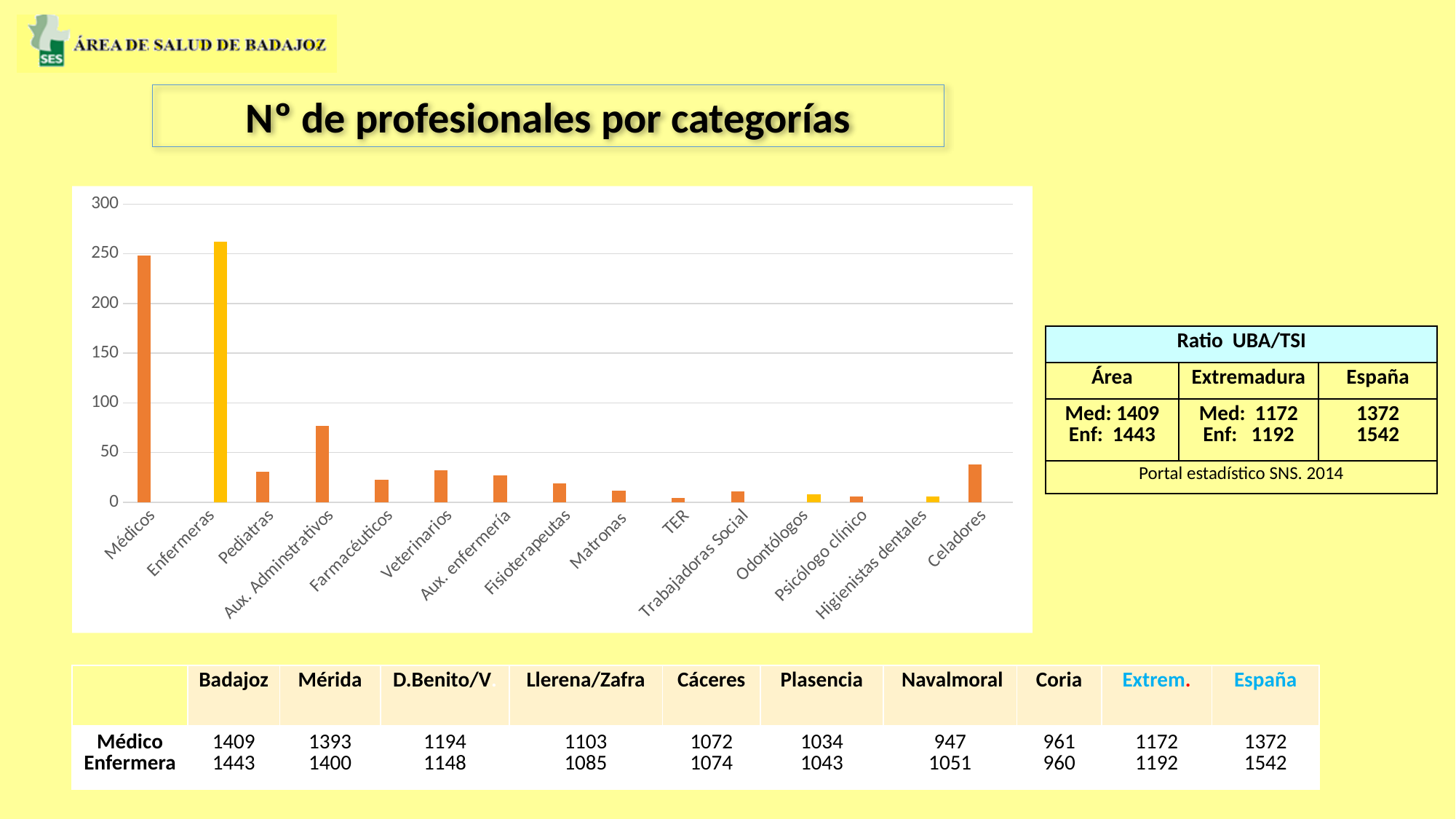
How many professional categories are shown on the x axis of the chart? 15 Is the value for Enfermeras greater or less than 250? greater Which is larger, the value for Farmacéuticos or the value for Matronas? Farmacéuticos Which category has the highest bar in the chart? Enfermeras Which is larger, the value for Médicos or the value for Enfermeras? Enfermeras Is the value for Celadores greater or less than 50? less Which is larger, the value for Aux. Administrativos or the value for Celadores? Aux. Administrativos What is the title of the chart? Nº de profesionales por categorías What type of chart is shown on the slide? bar chart Is the value for Médicos greater or less than 200? greater